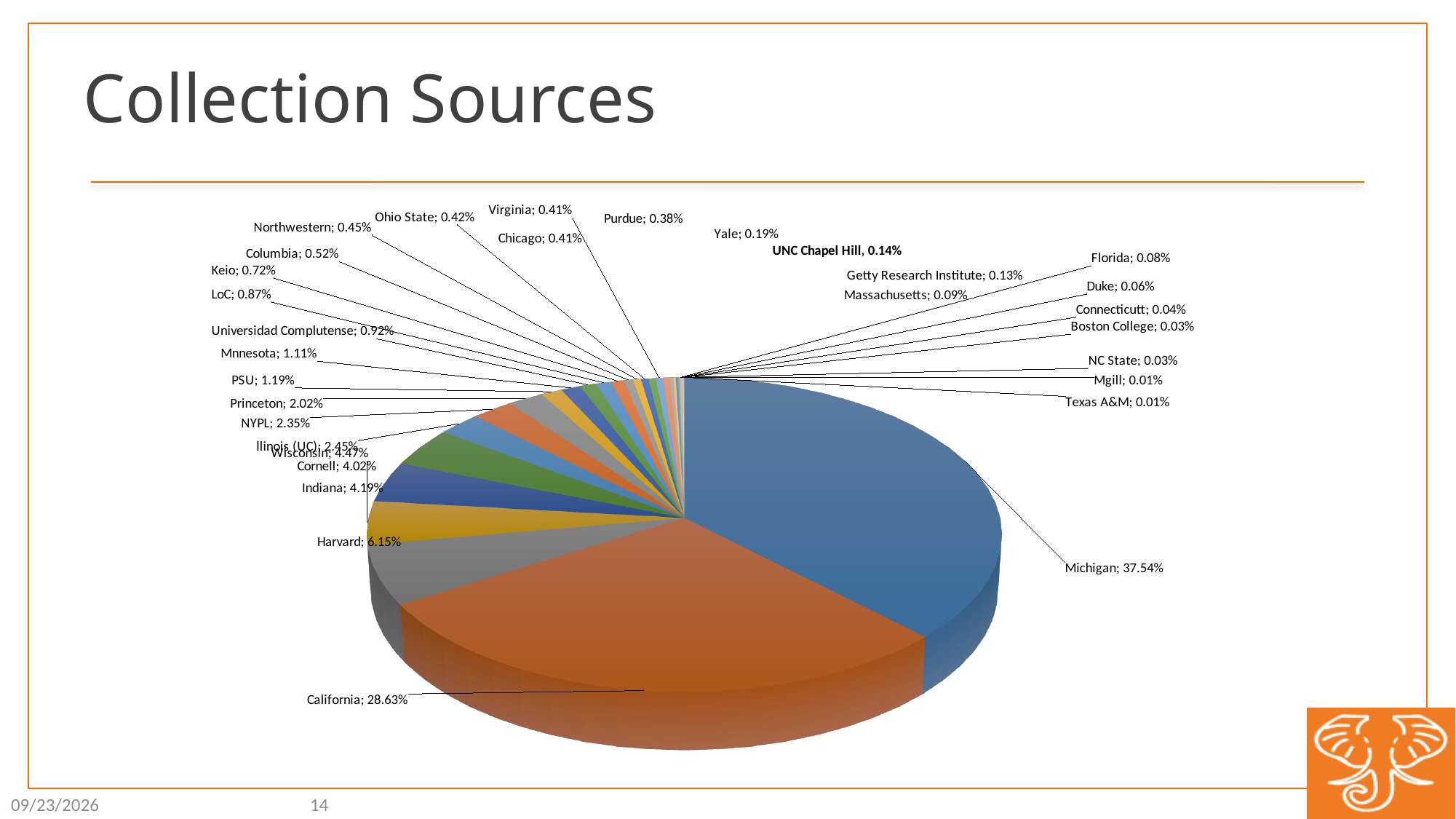
What is the value shown for California? 28.63% What is the combined share of Michigan and California? 66.17% What is the title of the chart on the slide? Collection Sources What is the value shown for Harvard? 6.15% What is the value shown for UNC Chapel Hill? 0.14% What is the difference between the Michigan and California shares? 8.91% What share of the pie does Michigan account for? 37.54% Which collection source has the largest share of the pie? Michigan Which is larger, the share for Wisconsin or the share for Cornell? Wisconsin What kind of chart is shown on the slide? pie chart What is the value shown for Princeton? 2.02% How many collection sources are labelled on the pie chart? 31